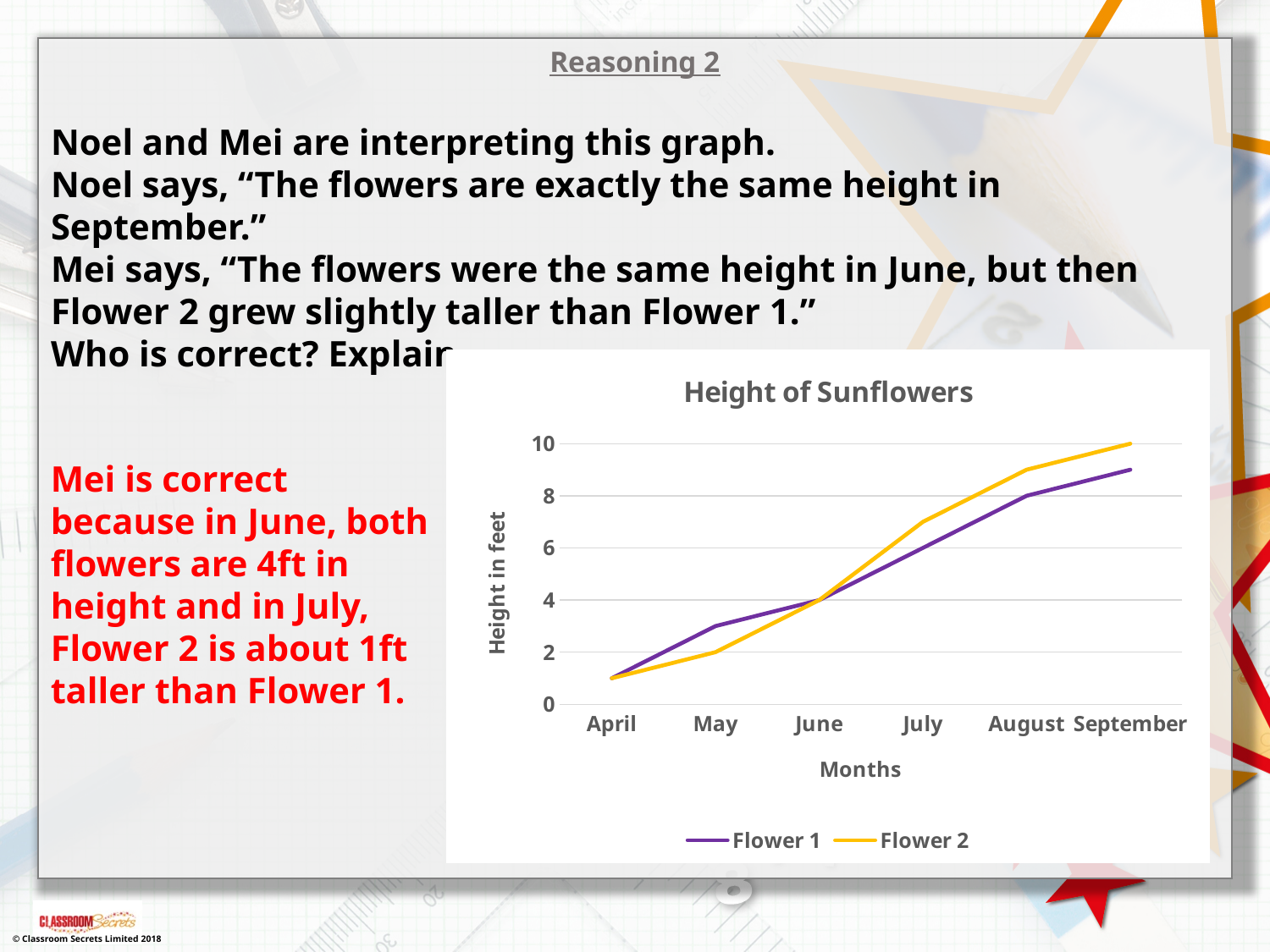
Which flower is taller in September, Flower 1 or Flower 2? Flower 2 Is the height of Flower 1 in September greater or less than 8? greater What is the height of Flower 1 in August? 8 Is the height of Flower 2 in July greater or less than 6? greater What is the height of Flower 2 in September? 10 What is the title of the chart? Height of Sunflowers What is the height of Flower 1 in June? 4 How many months are shown on the x axis of the chart? 6 How many series does the chart's legend list? 2 Which flower is taller in May, Flower 1 or Flower 2? Flower 1 Do the heights of the flowers rise or fall from April to September? Rise What type of chart is shown on the slide? Line chart